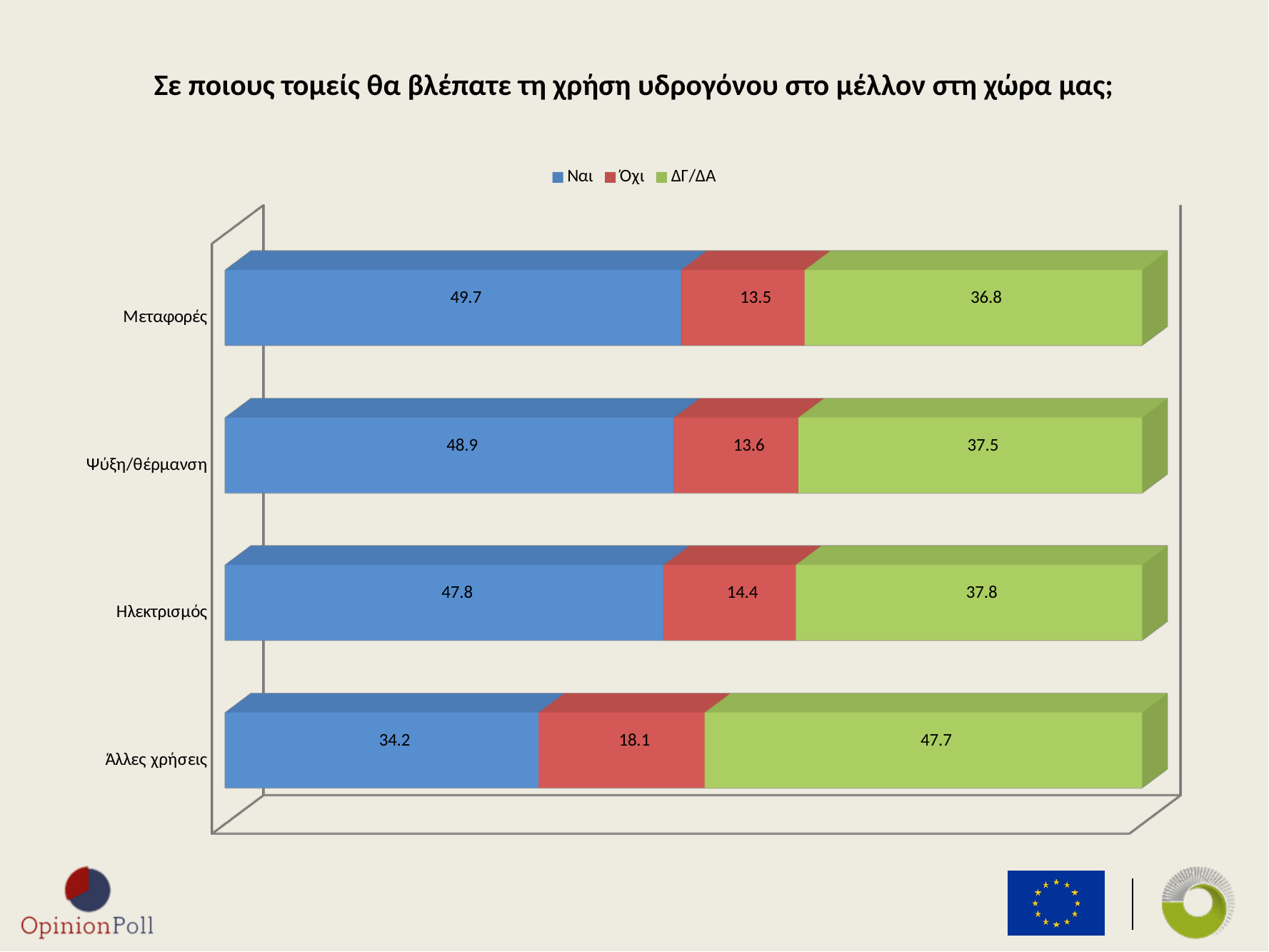
What is the total of the stacked bar for Ψύξη/θέρμανση? 100.0 How many series does the legend list? 3 What is the difference between the Ναι values for Μεταφορές and Άλλες χρήσεις? 15.5 What is the value of ΔΓ/ΔΑ for Άλλες χρήσεις? 47.7 Which category has the highest Ναι value? Μεταφορές Which category has the lowest Ναι value? Άλλες χρήσεις What is the value of Ναι for Μεταφορές? 49.7 What is the value of Όχι for Ηλεκτρισμός? 14.4 Which is larger: the ΔΓ/ΔΑ value for Ψύξη/θέρμανση or for Ηλεκτρισμός? Ηλεκτρισμός How many categories are shown in the chart? 4 What kind of chart is shown on the slide? Stacked bar chart Which category has the highest Όχι value? Άλλες χρήσεις